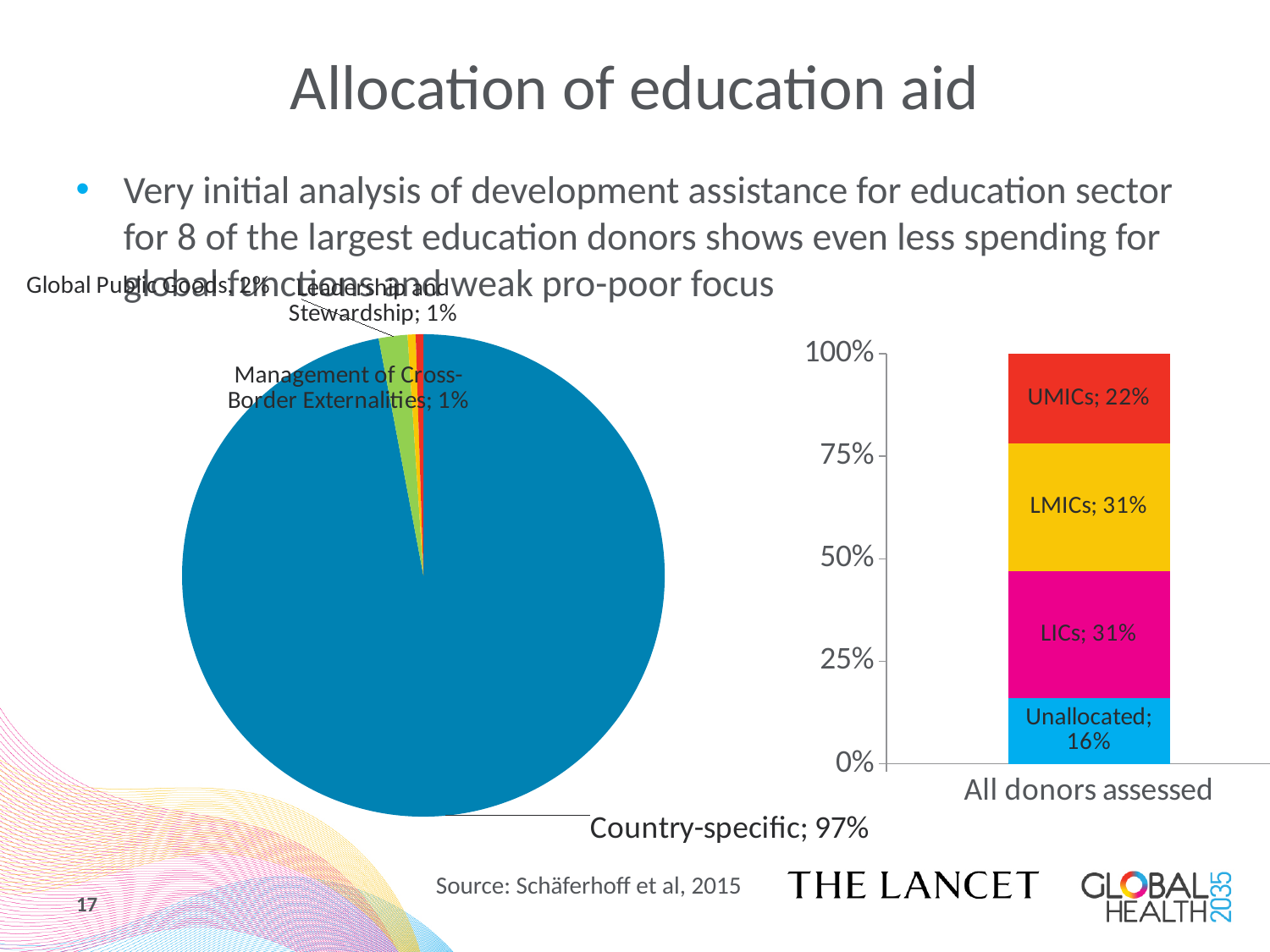
In the pie chart on the left, what share is labelled for Leadership and Stewardship? 1% In the pie chart on the left, what share is labelled for Country-specific? 97% How many slices does the pie chart on the left have? 4 In the stacked bar chart on the right, which is larger, UMICs or LMICs? LMICs In the stacked bar chart on the right, what is the difference between the UMICs value and the Unallocated value? 6 percentage points In the stacked bar chart on the right, what is the category label shown on the x axis? All donors assessed In the stacked bar chart on the right, which segment is the smallest? Unallocated In the pie chart on the left, which slice is the largest? Country-specific What kind of chart is the chart on the right of the slide? Stacked bar chart In the stacked bar chart on the right, what is the value for Unallocated? 16% In the stacked bar chart on the right, what is the value for UMICs? 22% What kind of chart is the chart on the left of the slide? Pie chart